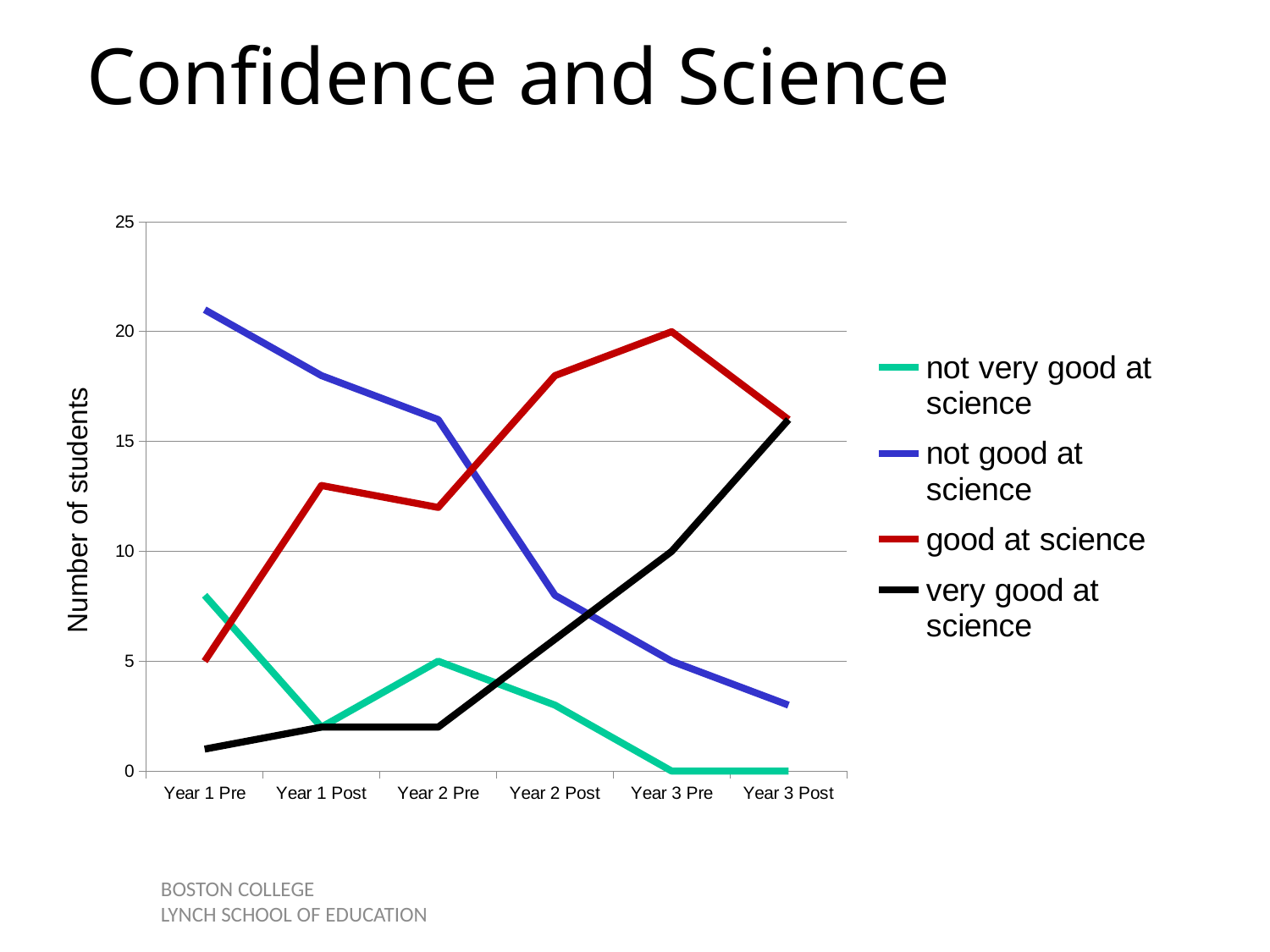
How many points are there along the x axis? 6 What kind of chart is shown on the slide? line chart Which series has the highest value at Year 1 Pre? not good at science Which series has the lowest value at Year 3 Post? not very good at science Does the "not good at science" series rise or fall from Year 1 Pre to Year 3 Post? fall Is the value for "very good at science" at Year 1 Pre greater or less than 5? less What is the value for "very good at science" at Year 3 Pre? 10 What is the value for "not very good at science" at Year 3 Post? 0 How many series does the legend list? 4 What is the value for "good at science" at Year 3 Pre? 20 Is the value for "not good at science" at Year 1 Pre greater or less than 20? greater At Year 2 Post, which is larger: "good at science" or "not good at science"? good at science